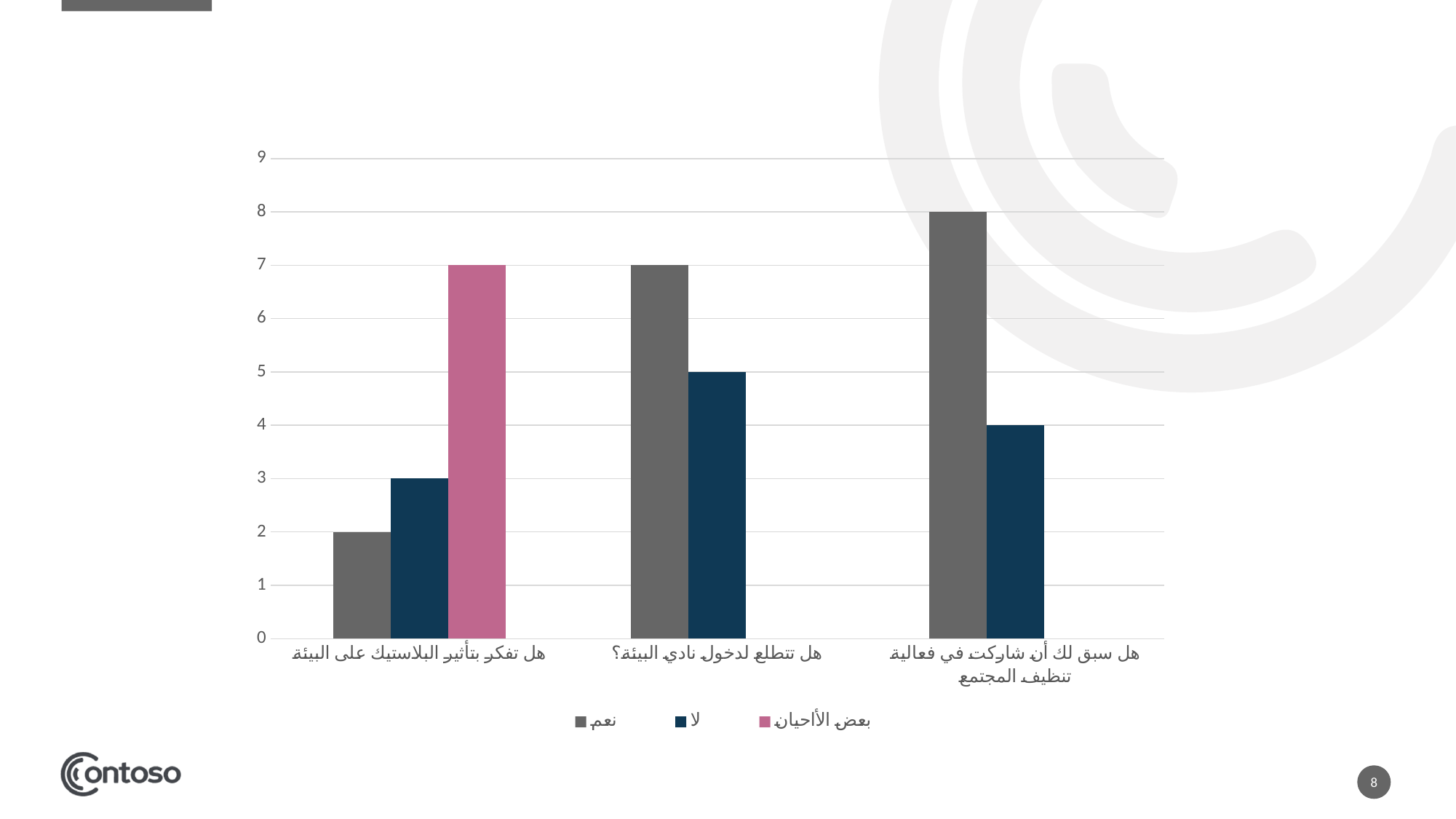
What type of chart is shown on the slide? bar chart Which category has the highest value for نعم? هل سبق لك أن شاركت في فعالية تنظيف المجتمع What is the difference between نعم and لا for هل سبق لك أن شاركت في فعالية تنظيف المجتمع? 4 What is the value of لا for هل تتطلع لدخول نادي البيئة؟? 5 Which is larger for هل تفكر بتأثير البلاستيك على البيئة: نعم or لا? لا Is the value of نعم for هل تتطلع لدخول نادي البيئة؟ greater or less than 5? greater What is the value of بعض الأحيان for هل تفكر بتأثير البلاستيك على البيئة? 7 What is the value of نعم for هل سبق لك أن شاركت في فعالية تنظيف المجتمع? 8 How many series does the legend list? 3 How many categories are shown on the x axis? 3 Which series is shown in pink in the legend? بعض الأحيان Which category has the lowest value for نعم? هل تفكر بتأثير البلاستيك على البيئة